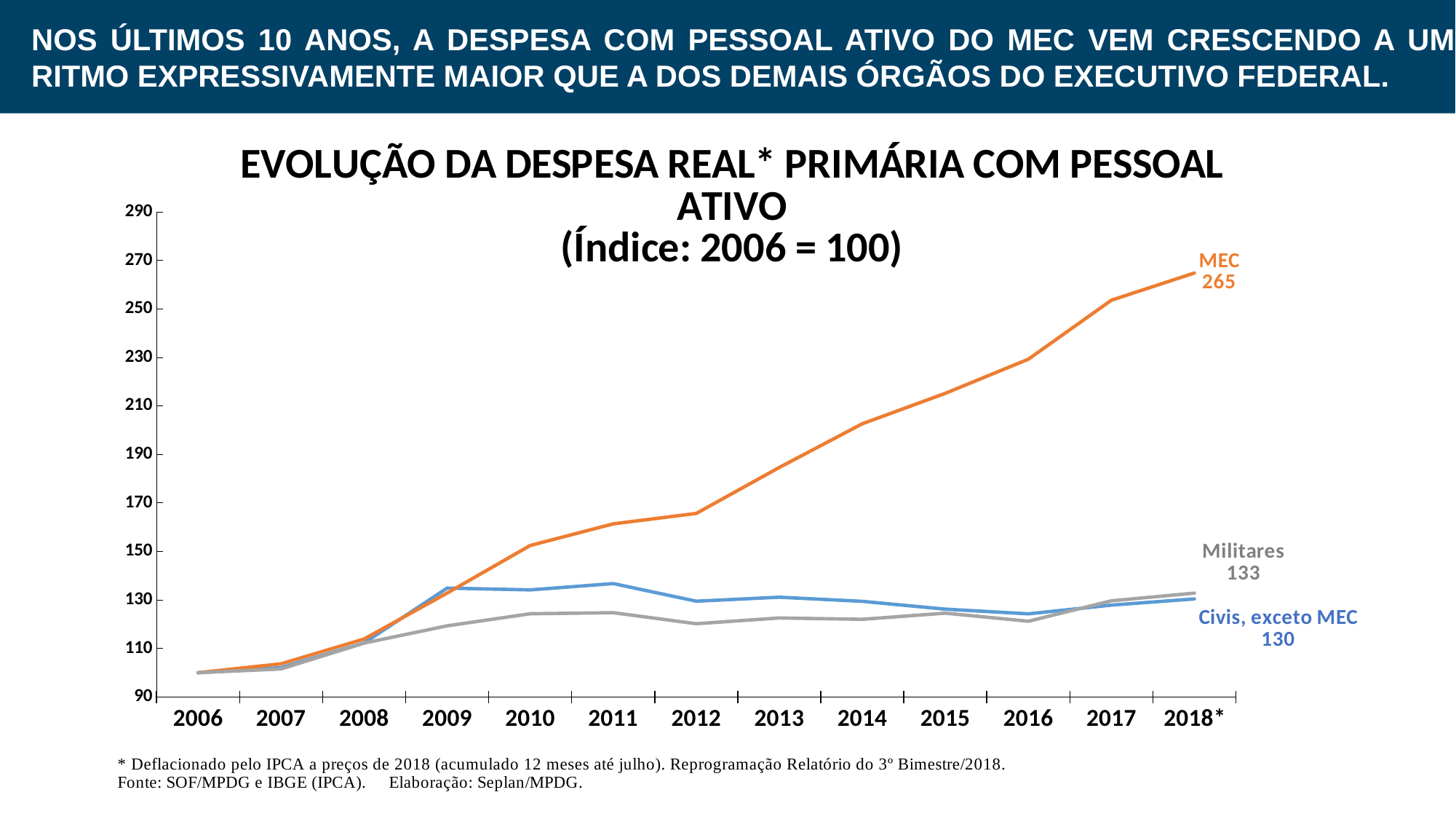
What is the value of the MEC series in 2018*? 265 Which series has the lowest value in 2018*? Civis, exceto MEC What is the difference between the MEC value and the Militares value in 2018*? 132 Is the value for MEC in 2012 greater or less than 150? greater What kind of chart is shown on the slide? Line chart Which is larger in 2018*: the MEC value or the Civis, exceto MEC value? MEC How many years are shown on the x axis? 13 Is the value for Militares in 2012 greater or less than 130? less What is the value of the Militares series in 2018*? 133 What is the value of the Civis, exceto MEC series in 2018*? 130 Which series has the highest value in 2018*? MEC How many series are plotted on the chart? 3